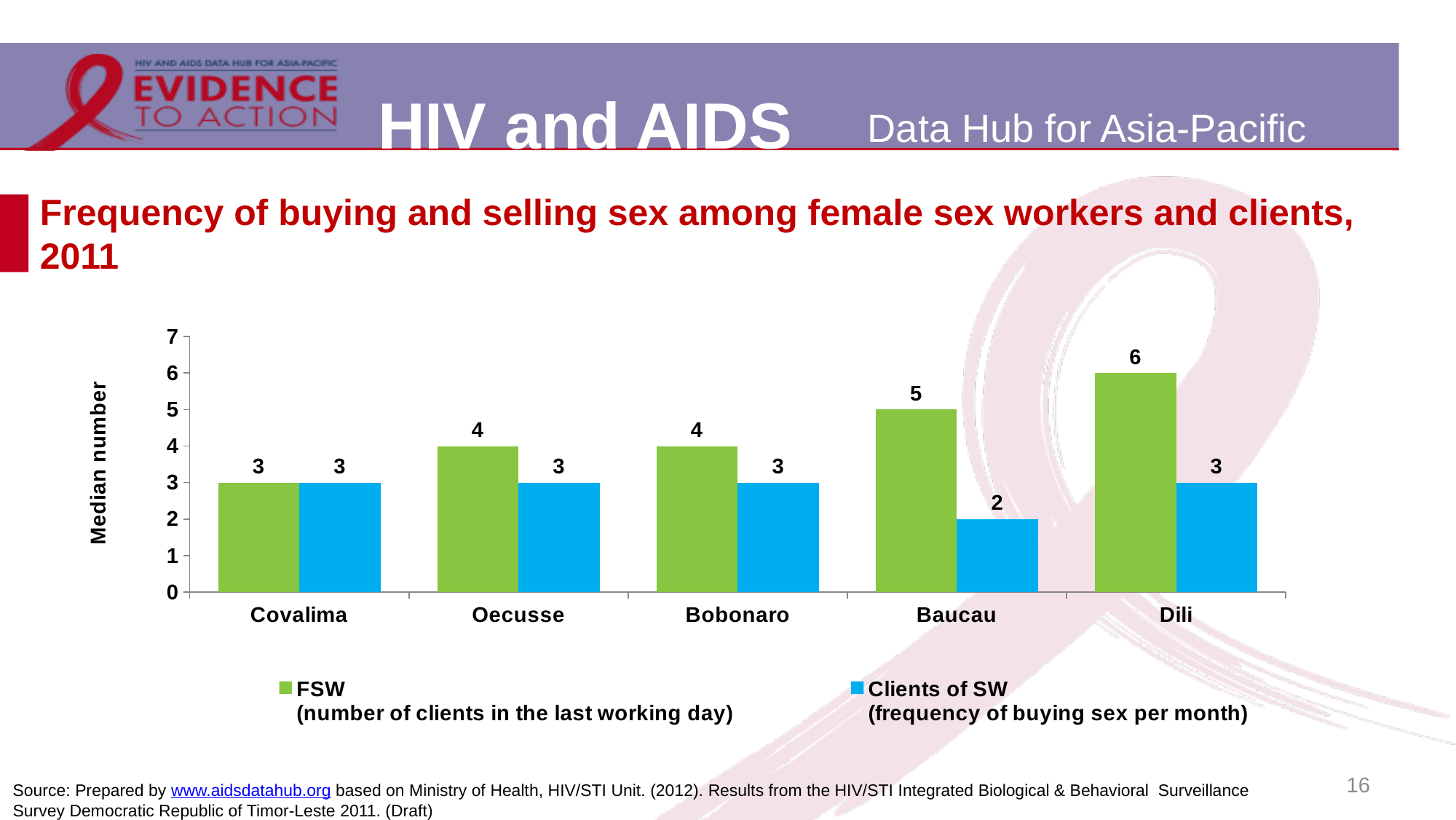
What is the difference between the FSW and Clients of SW values for Dili? 3 What is the difference between the FSW values for Baucau and Covalima? 2 How many districts are shown on the x axis? 5 How many series does the legend list? 2 Which district has the highest FSW value? Dili What is the FSW value for Dili? 6 What is the label of the y axis? Median number Which district has the lowest Clients of SW value? Baucau What is the FSW value for Oecusse? 4 What kind of chart is shown on the slide? Bar chart What is the Clients of SW value for Baucau? 2 Which is larger for Bobonaro, the FSW value or the Clients of SW value? FSW